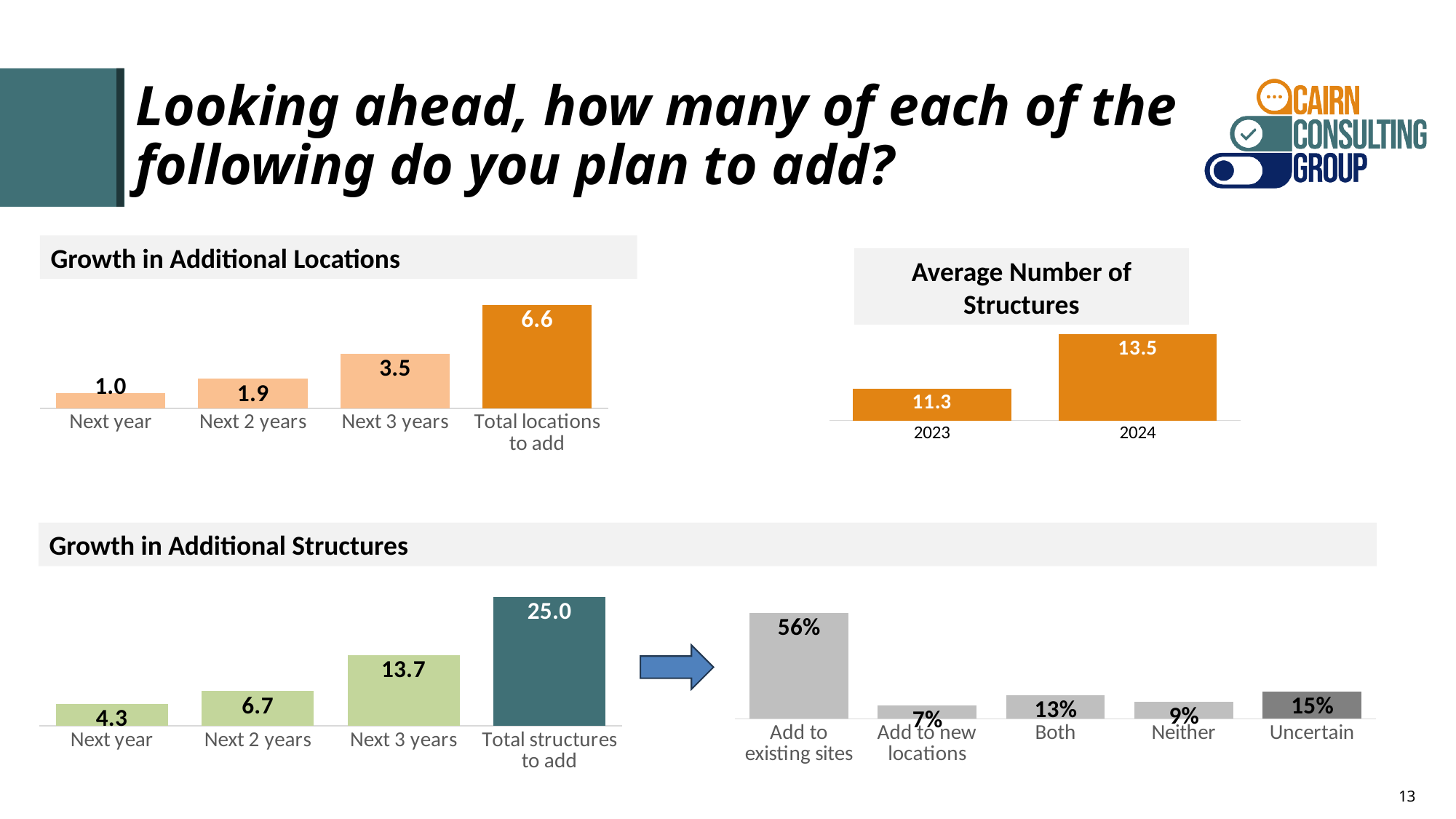
In the 'Growth in Additional Locations' chart, what is the value for Total locations to add? 6.6 In the 'Average Number of Structures' chart, what is the difference between 2024 and 2023? 2.2 How many categories are shown in the bottom-right chart of percentages? 5 In the bottom-right chart of percentages, which is larger, Both or Uncertain? Uncertain In the 'Growth in Additional Structures' chart, what is the value for Next 2 years? 6.7 In the bottom-right chart of percentages, which category has the lowest value? Add to new locations What type of chart is the 'Growth in Additional Locations' chart? Bar chart In the 'Growth in Additional Structures' chart, which category has the highest value? Total structures to add In the 'Growth in Additional Locations' chart, what is the value for Next 3 years? 3.5 In the 'Average Number of Structures' chart, what is the value for 2024? 13.5 In the bottom-right chart of percentages, what is the value for Add to existing sites? 56% In the 'Growth in Additional Structures' chart, what is the difference between Next 3 years and Next year? 9.4